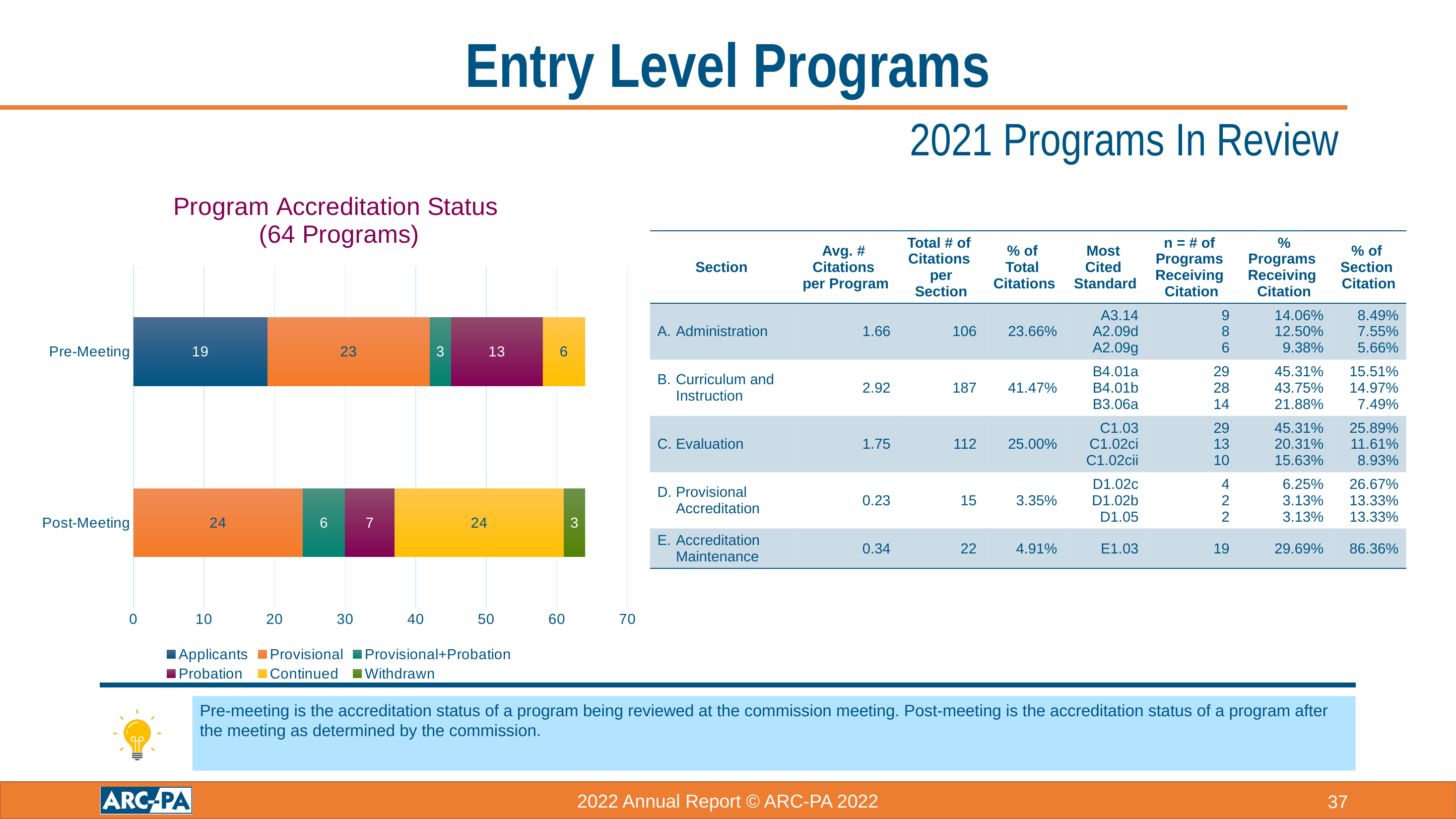
What kind of chart is 'Program Accreditation Status (64 Programs)'? Stacked bar chart In the Program Accreditation Status chart, what is the Probation value for Pre-Meeting? 13 In the Program Accreditation Status chart, what is the Provisional value for Post-Meeting? 24 In the Program Accreditation Status chart, how many categories are shown on the vertical axis? 2 In the Program Accreditation Status chart, what is the Continued value for Pre-Meeting? 6 In the Program Accreditation Status chart, which is larger: the Probation value for Pre-Meeting or for Post-Meeting? Pre-Meeting In the Program Accreditation Status chart, how many programs were Withdrawn at Post-Meeting? 3 In the Program Accreditation Status chart, how many programs were Applicants at Pre-Meeting? 19 In the Program Accreditation Status chart, how many series does the legend list? 6 In the Program Accreditation Status chart, what is the total of the Post-Meeting stacked bar? 64 In the Program Accreditation Status chart, which segment is the largest in the Pre-Meeting bar? Provisional In the Program Accreditation Status chart, what is the difference between the Continued values for Post-Meeting and Pre-Meeting? 18